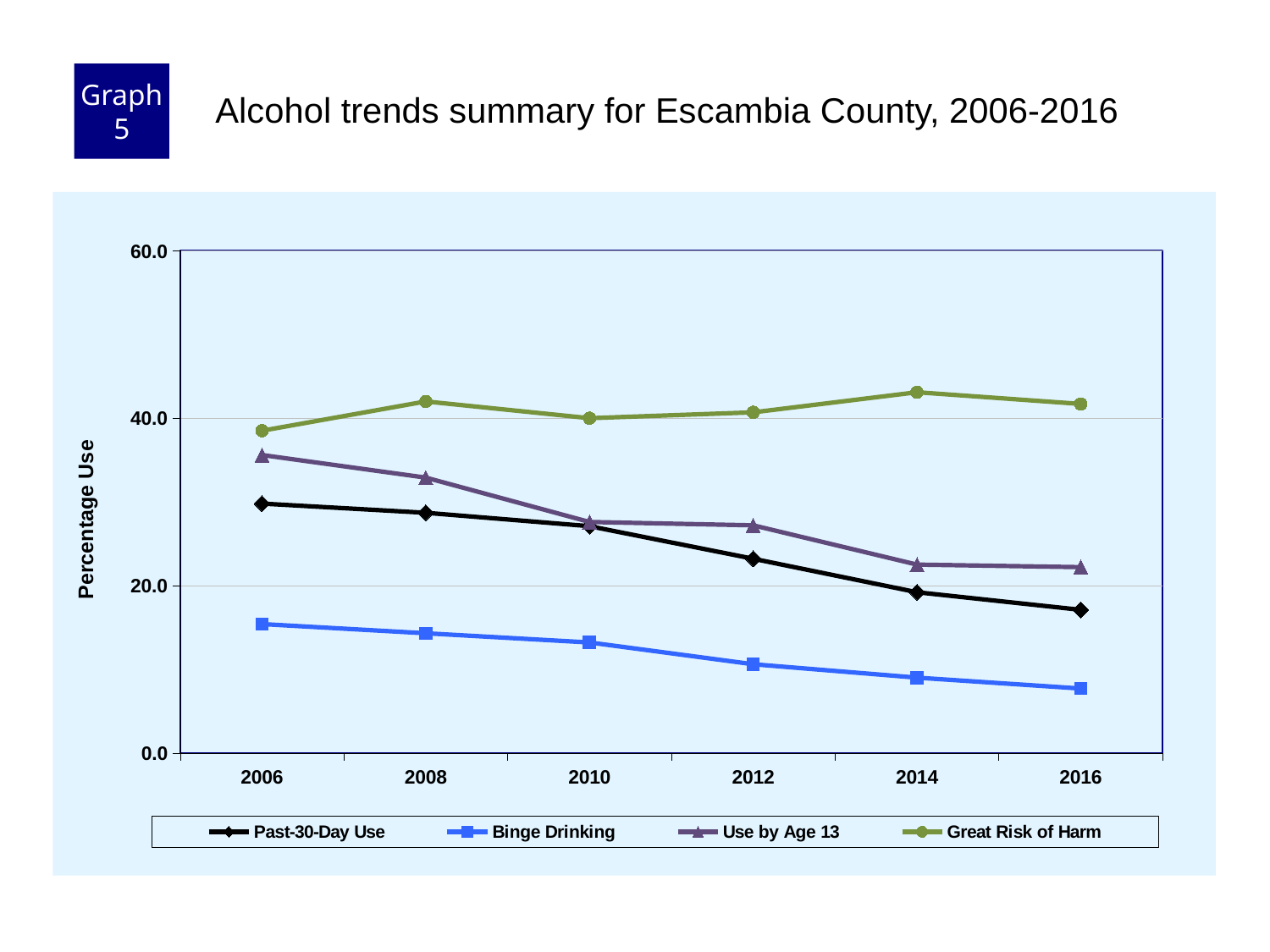
What is the label on the y axis? Percentage Use In 2006, which is larger: Use by Age 13 or Past-30-Day Use? Use by Age 13 Is the value for Binge Drinking in 2006 greater or less than 20? less Is the value for Great Risk of Harm in 2008 greater or less than 40? greater Is the value for Past-30-Day Use in 2016 greater or less than 20? less How many years are plotted along the x axis? 6 Which series has the lowest value in 2016? Binge Drinking What kind of chart is shown on the slide? line chart Which series has the highest value in 2016? Great Risk of Harm How many series does the legend list? 4 Does the Binge Drinking series rise or fall from 2006 to 2016? fall